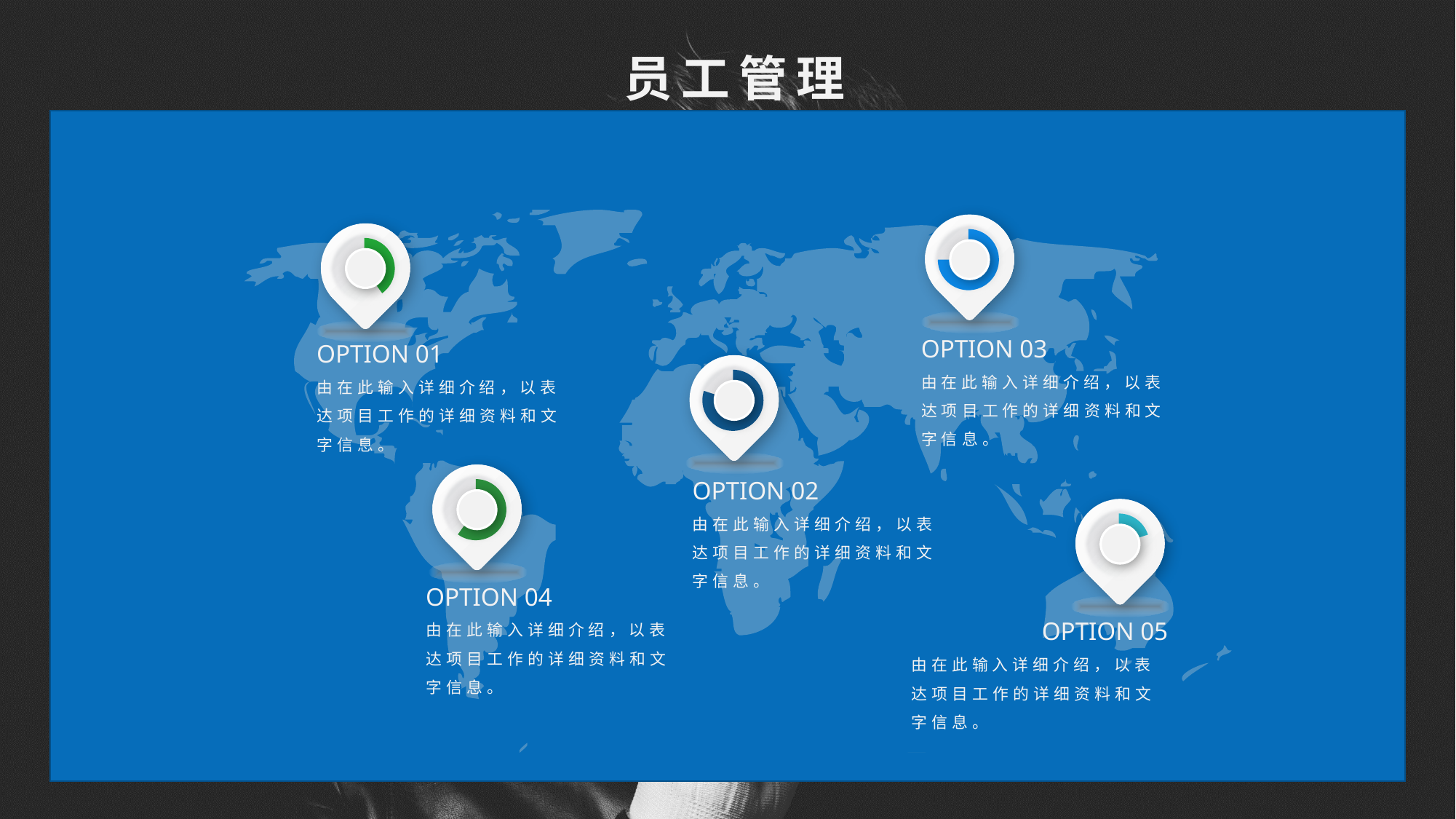
What is the title of the slide containing the map with the ring indicators? 员工管理 What colour is the filled arc of the OPTION 01 ring indicator? green Which option label is placed at the bottom right of the map? OPTION 05 Which option's ring indicator has the largest filled portion? OPTION 02 How many option markers with ring indicators are placed on the map? 5 Is the filled portion of the OPTION 02 ring larger or smaller than that of the OPTION 05 ring? larger What kind of chart is shown inside each location pin on the map? donut (ring) chart